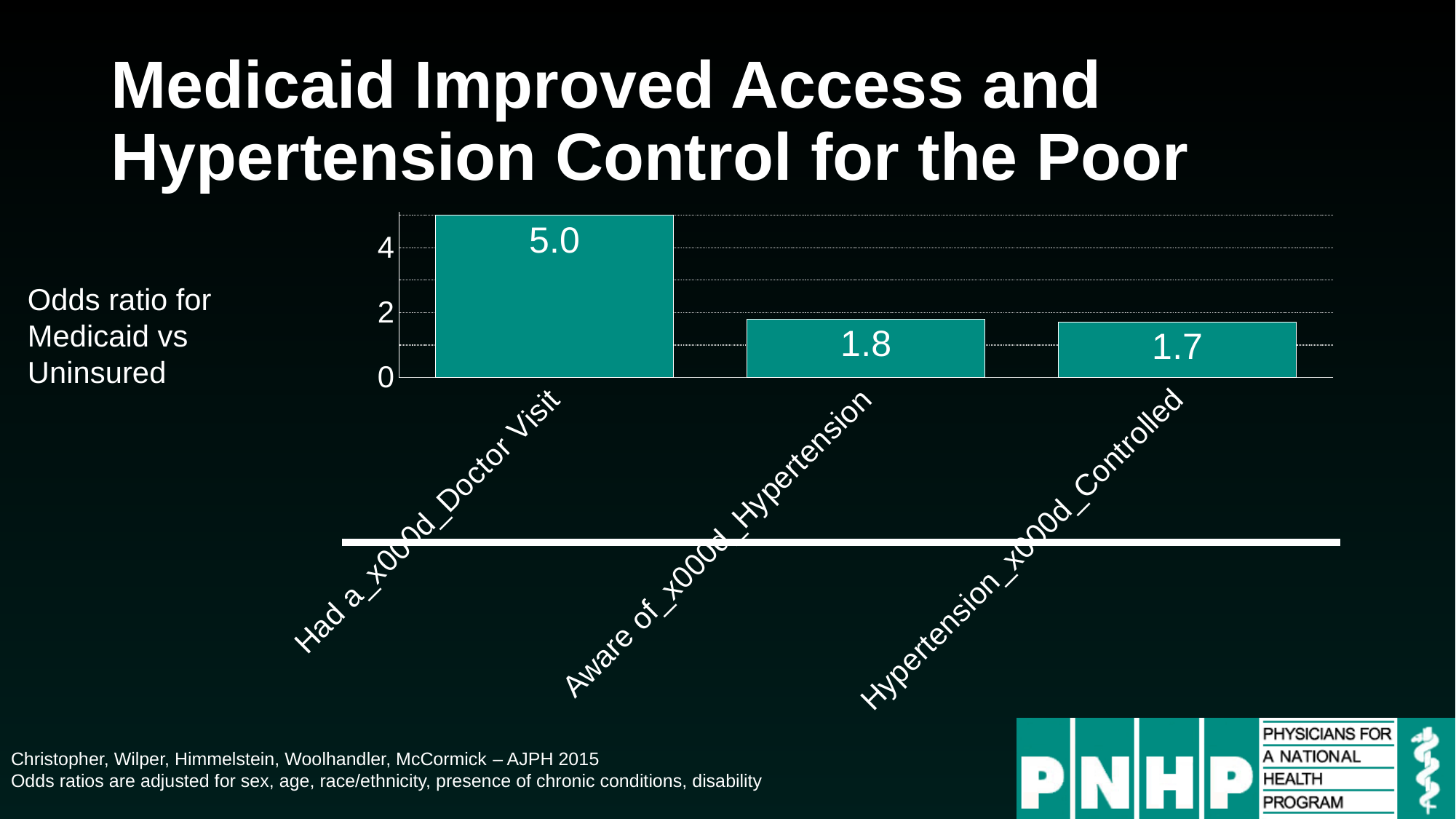
What is the difference between the odds ratio for "Aware of Hypertension" and for "Hypertension Controlled"? 0.1 Which category has the highest odds ratio? Had a Doctor Visit Do the values rise or fall from left to right across the categories? fall What is the odds ratio for "Had a Doctor Visit"? 5.0 What is the odds ratio for "Aware of Hypertension"? 1.8 What is the odds ratio for "Hypertension Controlled"? 1.7 What kind of chart is shown on the slide? bar chart Which is larger, the odds ratio for "Had a Doctor Visit" or for "Hypertension Controlled"? Had a Doctor Visit How many categories are shown in the chart? 3 Is the value for "Had a Doctor Visit" greater or less than 4? greater What is the difference between the odds ratio for "Had a Doctor Visit" and for "Aware of Hypertension"? 3.2 Which category has the lowest odds ratio? Hypertension Controlled